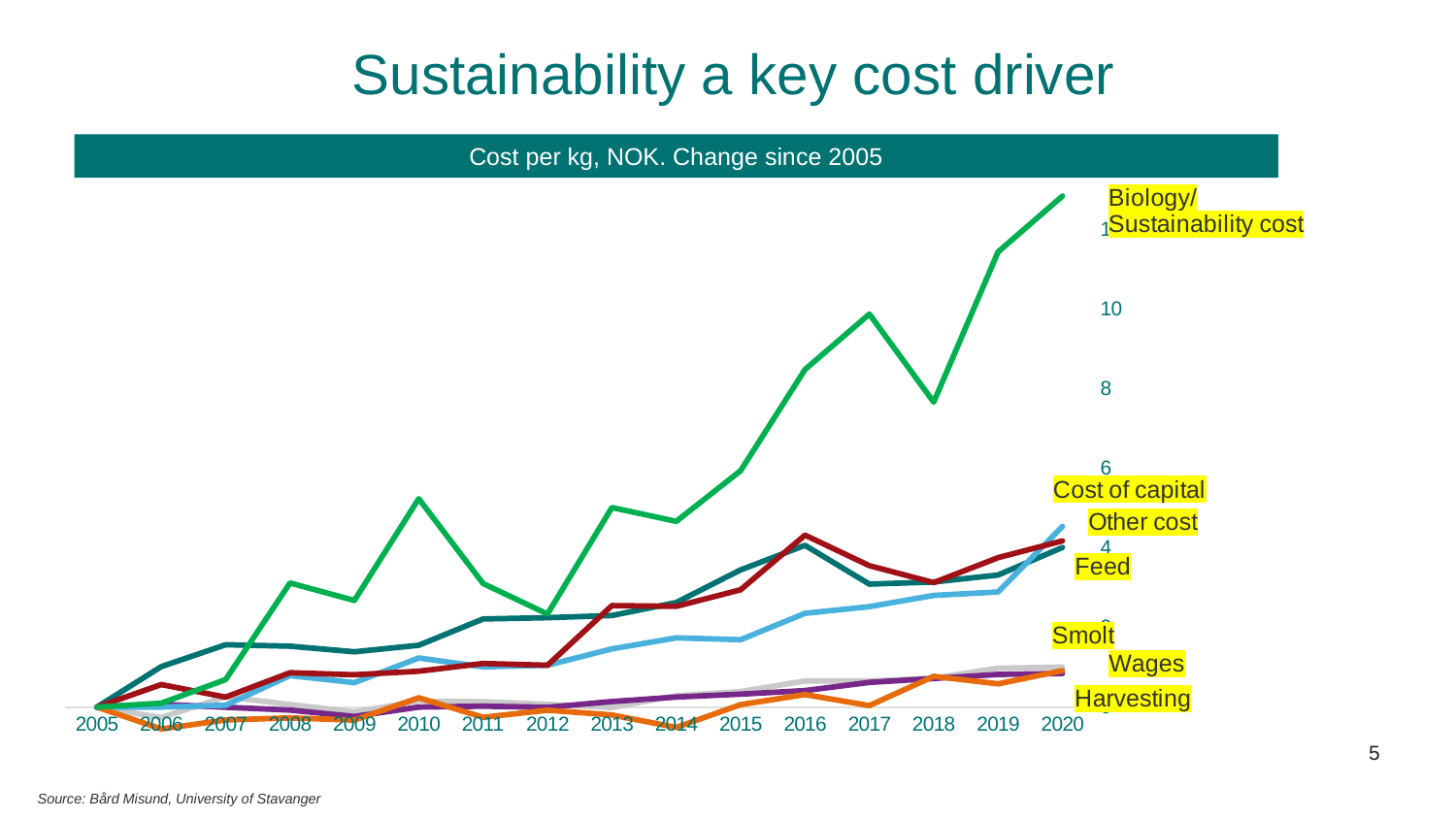
What kind of chart is shown on the slide? Line chart How many cost series are labelled on the chart? 7 Is the value for Biology/Sustainability cost in 2020 greater or less than 10? greater Does the Biology/Sustainability cost line generally rise or fall from 2005 to 2020? Rise How many years are shown along the x axis of the chart? 16 Is the value for Biology/Sustainability cost in 2010 greater or less than 6? less What is the title of the chart? Cost per kg, NOK. Change since 2005 Is the value for Harvesting in 2020 greater or less than 2? less In 2020, which is larger: Biology/Sustainability cost or Feed? Biology/Sustainability cost Which cost series has the highest value in 2020? Biology/Sustainability cost In 2020, which is larger: Other cost or Harvesting? Other cost